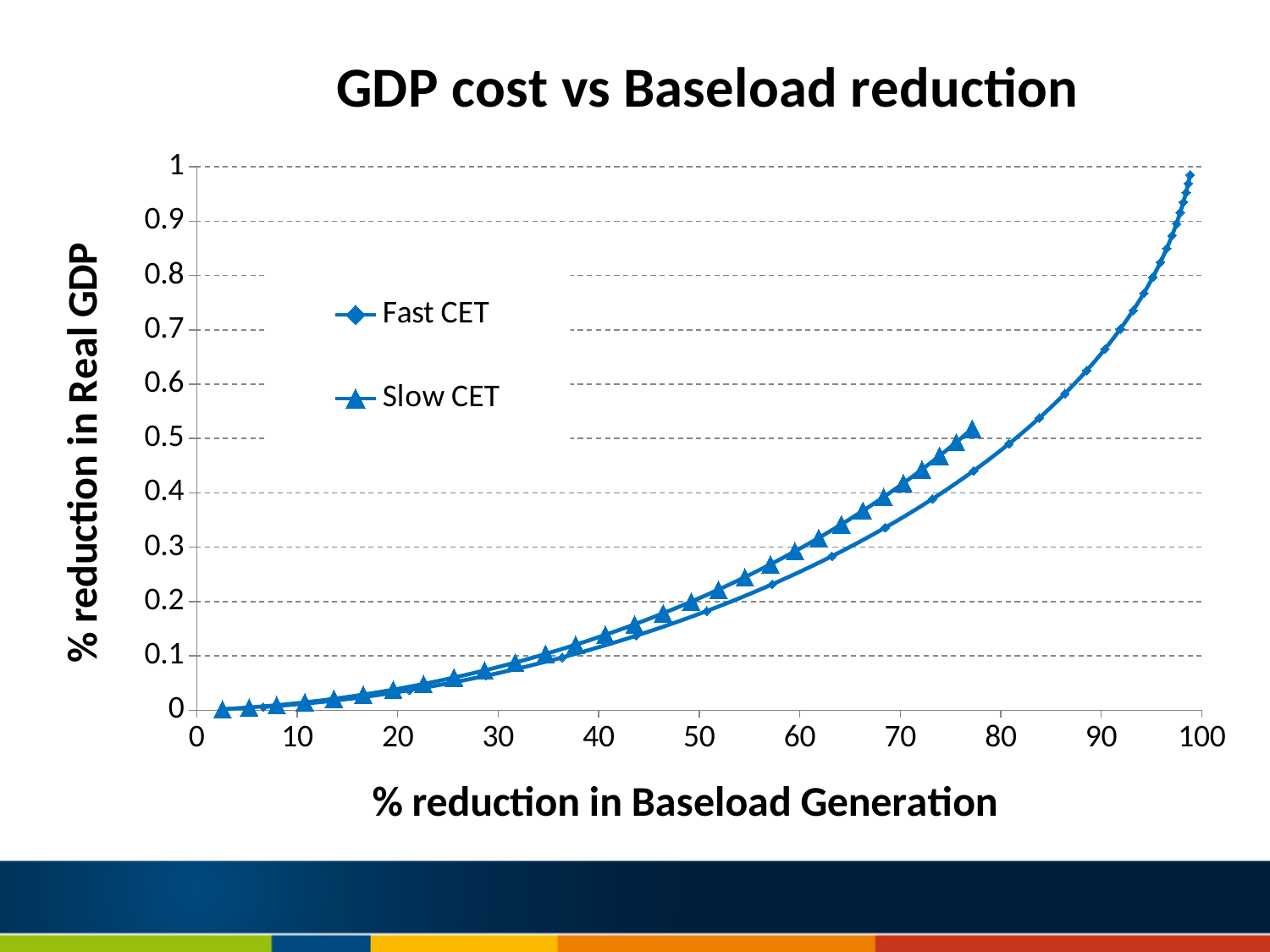
Which series reaches the highest % reduction in Real GDP? Fast CET Do the values for Fast CET rise or fall as the % reduction in Baseload Generation increases? rise Which series extends further along the x axis (to a larger % reduction in Baseload Generation)? Fast CET What are the two series named in the legend? Fast CET and Slow CET What kind of chart is shown on the slide? line chart Do the values for Slow CET rise or fall along the x axis? rise Is the Slow CET value at a 40% reduction in Baseload Generation greater or less than 0.1? greater Is the Fast CET value at a 60% reduction in Baseload Generation greater or less than 0.3? less How many series does the legend list? 2 At a 70% reduction in Baseload Generation, which series shows the larger % reduction in Real GDP? Slow CET Is the Fast CET value at a 90% reduction in Baseload Generation greater or less than 0.6? greater What is the title of the chart? GDP cost vs Baseload reduction